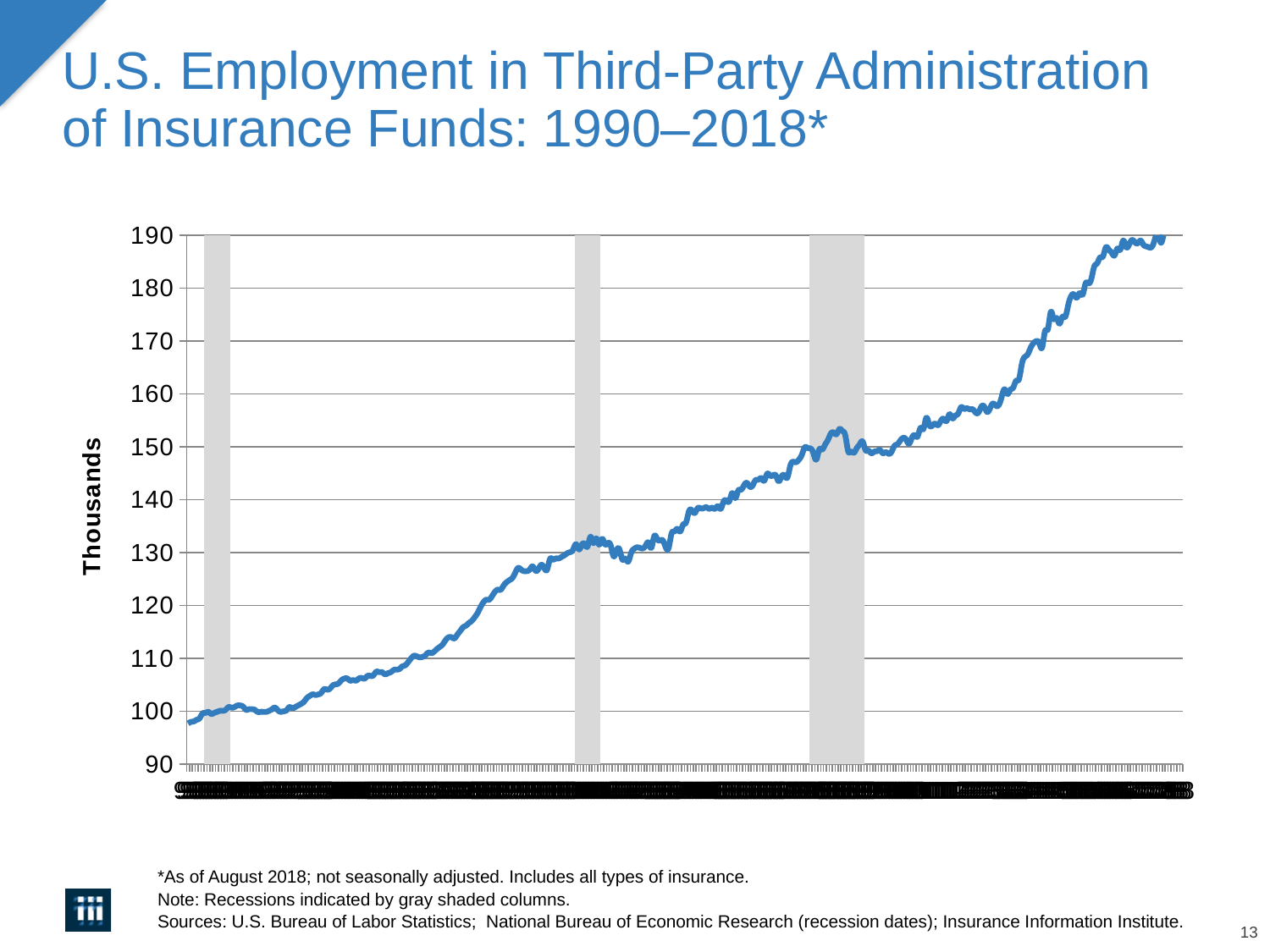
What is the highest tick value shown on the vertical axis? 190 Is the value during the second gray recession band greater or less than 140? less Is the value at the end of the series higher or lower than the value at the start of the series? higher Is the value at the start of the series (1990) greater or less than 110? less Overall, do the values rise or fall from 1990 to 2018 along the x axis? rise Is the peak value just before the third gray recession band greater or less than 160? less What is the label on the vertical axis of the chart? Thousands How many gray shaded recession columns are shown on the chart? 3 What kind of chart is shown on the slide? line chart